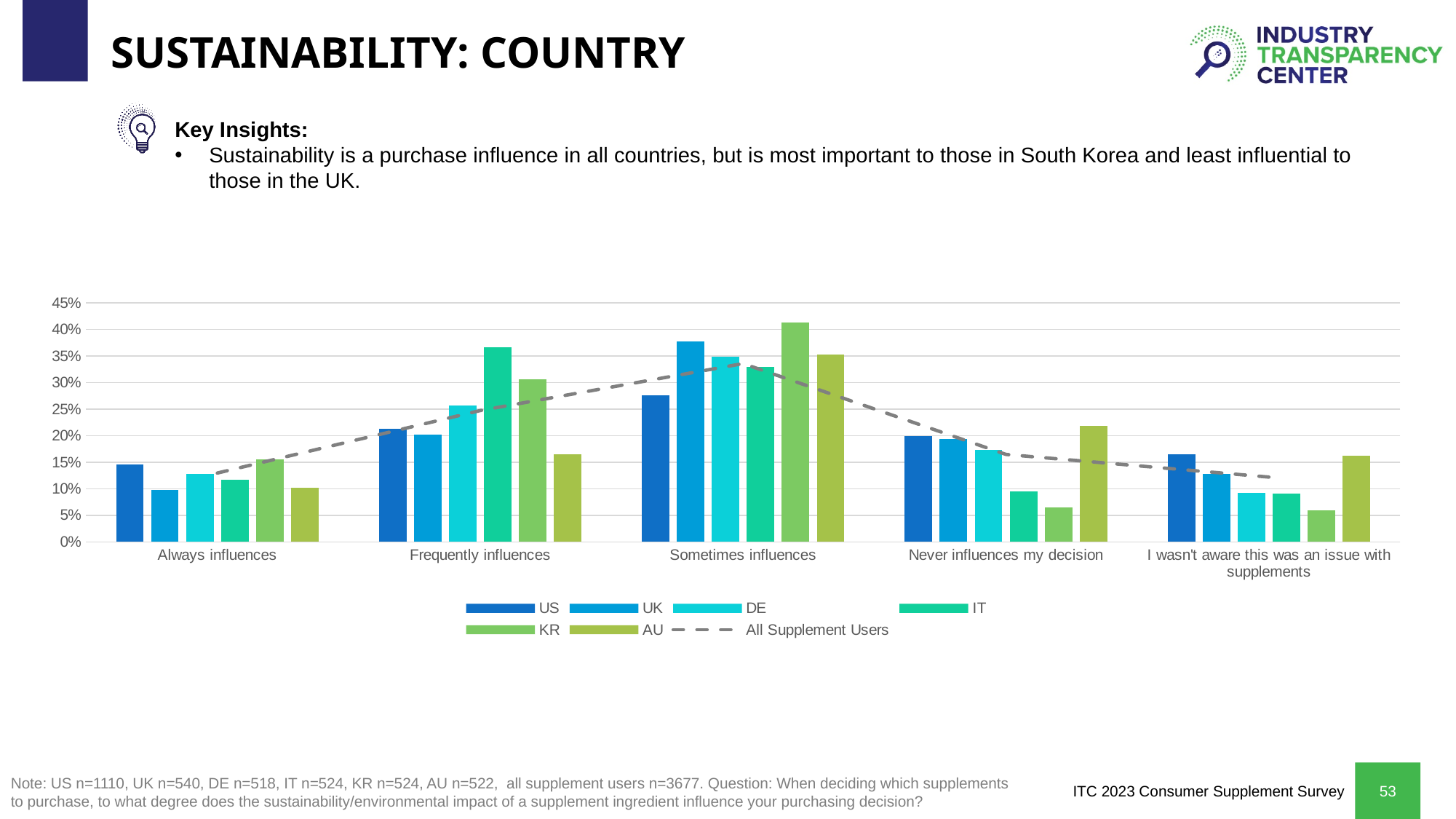
In the 'Frequently influences' category, which country has the highest bar? IT In the 'Never influences my decision' category, which is larger: the value for AU or the value for US? AU In the 'Never influences my decision' category, which country has the lowest bar? KR Which series in the legend is drawn as a dashed line rather than bars? All Supplement Users Is the value for IT in the 'Frequently influences' category greater or less than 35%? greater In the 'Sometimes influences' category, which country has the highest bar? KR What kind of chart is shown on the slide? combination bar and line chart Is the value for US in the 'Sometimes influences' category greater or less than 30%? less How many series does the chart's legend list? 7 Is the value for KR in the 'Sometimes influences' category greater or less than 40%? greater How many response categories are shown along the x axis of the chart? 5